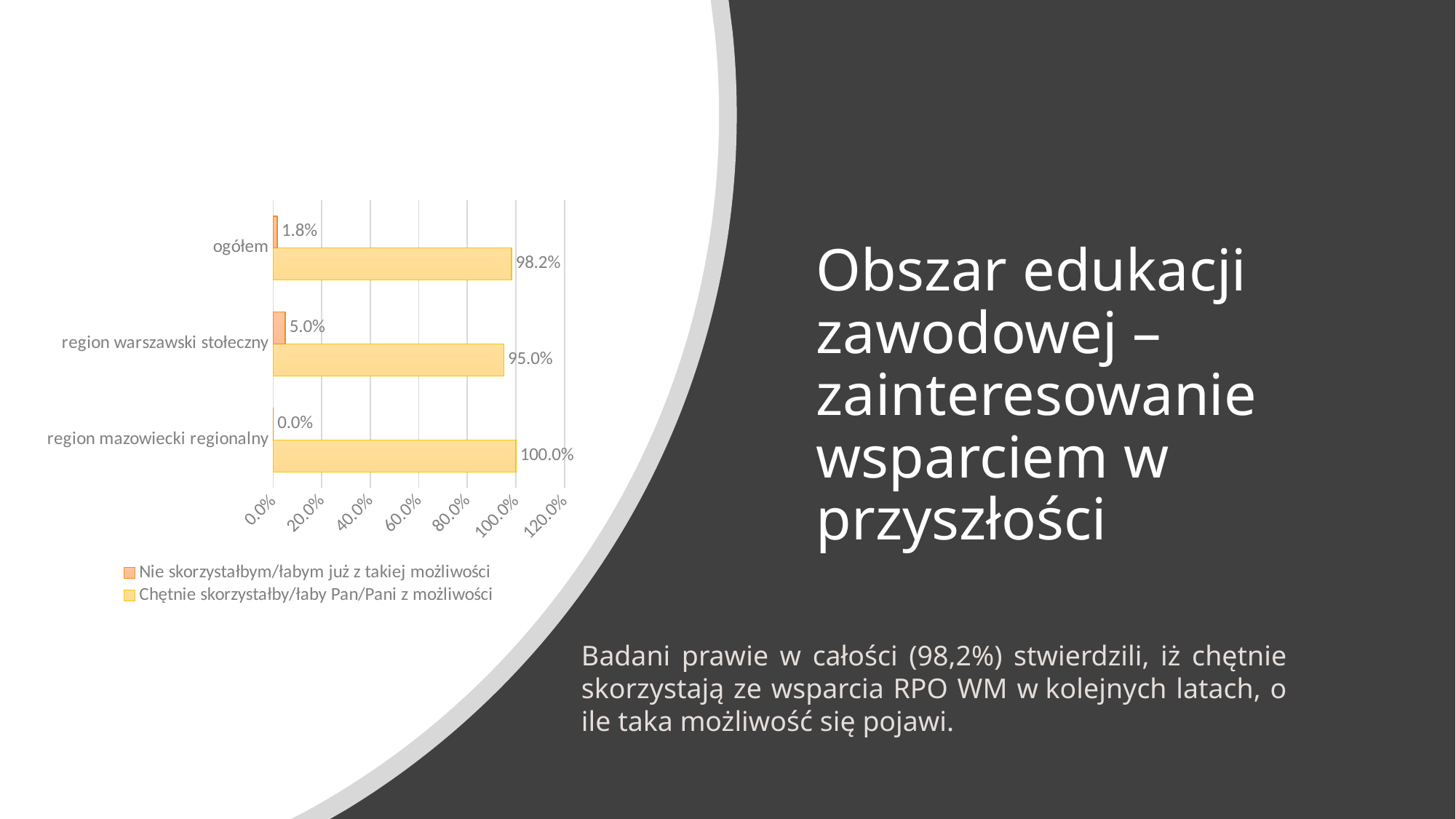
How many series does the legend list? 2 What colour are the bars for the series 'Chętnie skorzystałby/łaby Pan/Pani z możliwości'? yellow What is the value for 'ogółem' in the series 'Nie skorzystałbym/łabym już z takiej możliwości'? 1.8% What is the value for 'region mazowiecki regionalny' in the series 'Chętnie skorzystałby/łaby Pan/Pani z możliwości'? 100.0% How many categories are shown on the chart? 3 What kind of chart is shown on the slide? bar chart Which category has the lowest value in the series 'Chętnie skorzystałby/łaby Pan/Pani z możliwości'? region warszawski stołeczny What is the difference between the 'Chętnie skorzystałby/łaby Pan/Pani z możliwości' values for 'region mazowiecki regionalny' and 'region warszawski stołeczny'? 5.0% What is the value for 'ogółem' in the series 'Chętnie skorzystałby/łaby Pan/Pani z możliwości'? 98.2% Which is larger: the 'Nie skorzystałbym/łabym już z takiej możliwości' value for 'region warszawski stołeczny' or for 'ogółem'? region warszawski stołeczny Which category has the highest value in the series 'Nie skorzystałbym/łabym już z takiej możliwości'? region warszawski stołeczny What is the value for 'region warszawski stołeczny' in the series 'Nie skorzystałbym/łabym już z takiej możliwości'? 5.0%